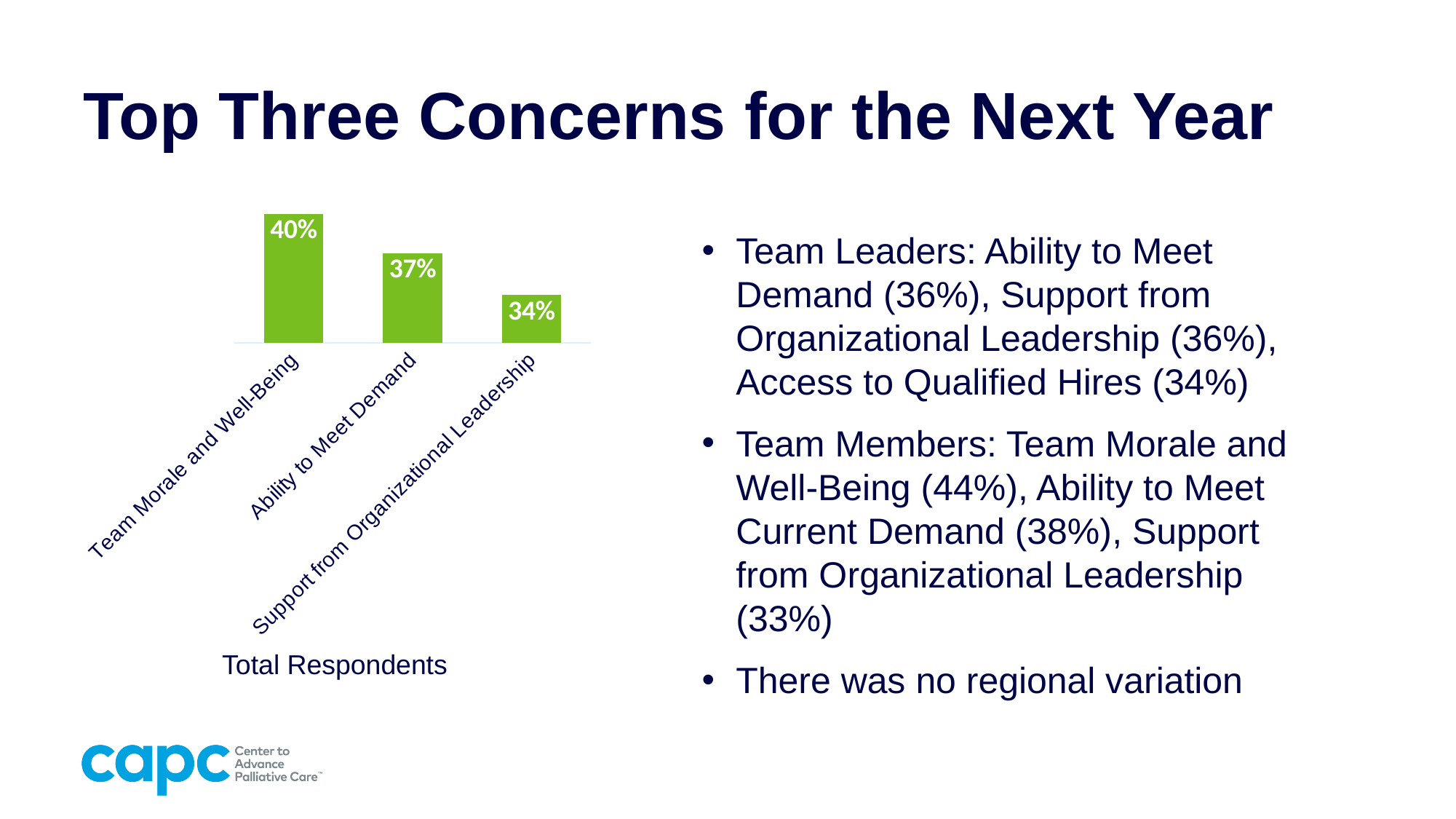
What is the value for Support from Organizational Leadership? 34% Which category has the highest value? Team Morale and Well-Being What is the value for Ability to Meet Demand? 37% Do the values rise or fall from left to right across the categories? Fall What kind of chart is shown on the slide? Bar chart Which is larger, the value for Team Morale and Well-Being or the value for Ability to Meet Demand? Team Morale and Well-Being How many categories are shown in the chart? 3 What is the difference between the values for Team Morale and Well-Being and Support from Organizational Leadership? 6% Which category has the lowest value? Support from Organizational Leadership What is the difference between the values for Ability to Meet Demand and Support from Organizational Leadership? 3% What is the value for Team Morale and Well-Being? 40% What is the title shown below the chart? Total Respondents